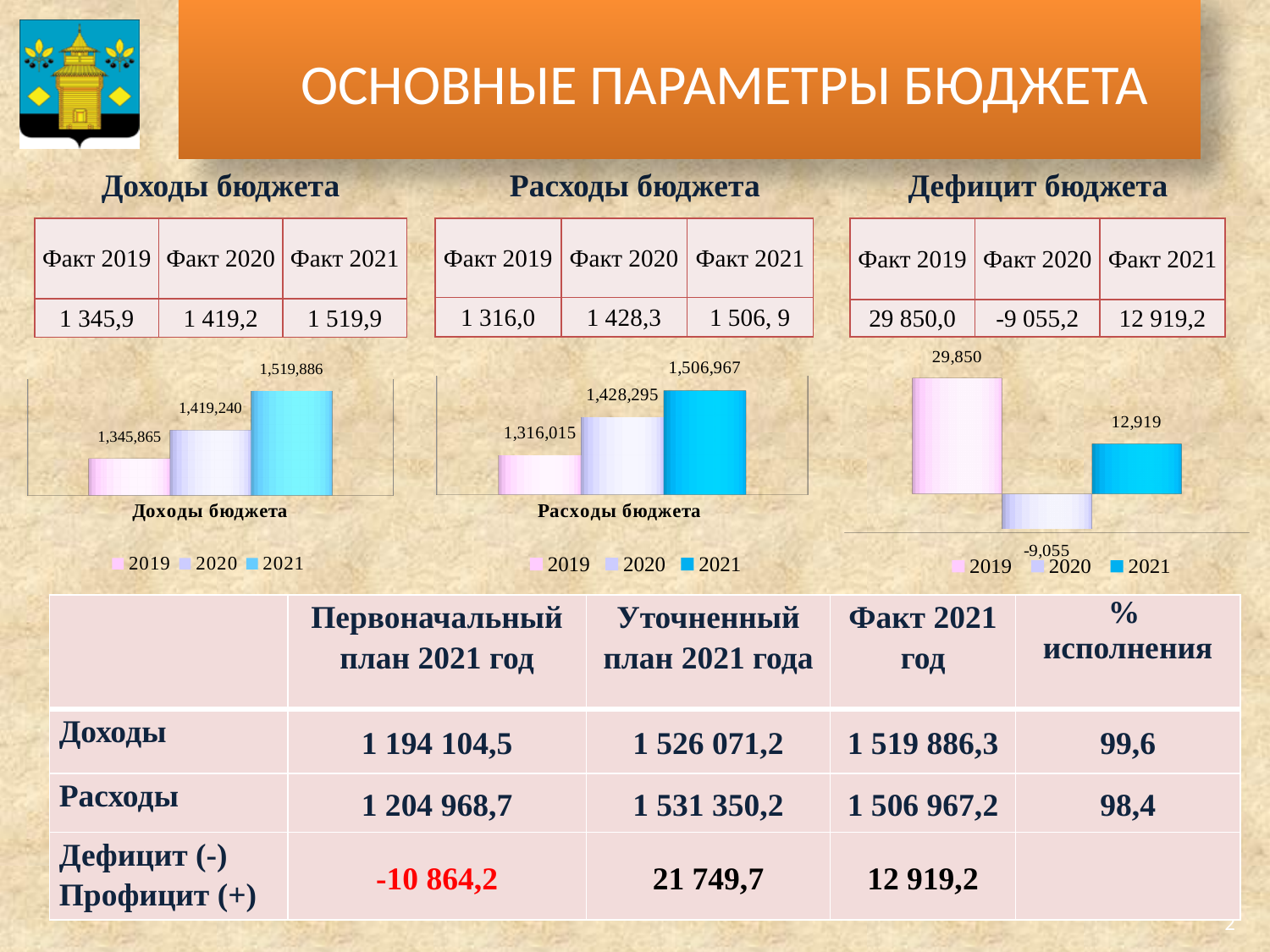
In the middle chart titled "Расходы бюджета", what is the value for 2020? 1,428,295 In the middle chart titled "Расходы бюджета", which is larger: the value for 2020 or the value for 2021? 2021 In the left chart titled "Доходы бюджета", what is the difference between the 2021 and 2019 values? 174,021 How many bars are plotted in the right chart titled "Дефицит бюджета"? 3 In the left chart titled "Доходы бюджета", what is the value for 2019? 1,345,865 In the left chart titled "Доходы бюджета", do the values rise or fall from 2019 to 2021? rise In the right chart titled "Дефицит бюджета", which year has the highest value? 2019 How many entries does the legend of the left chart titled "Доходы бюджета" list? 3 In the left chart titled "Доходы бюджета", what is the value for 2021? 1,519,886 In the right chart titled "Дефицит бюджета", what is the value for 2020? -9,055 In the middle chart titled "Расходы бюджета", which year has the lowest value? 2019 What kind of chart is the middle chart titled "Расходы бюджета"? bar chart